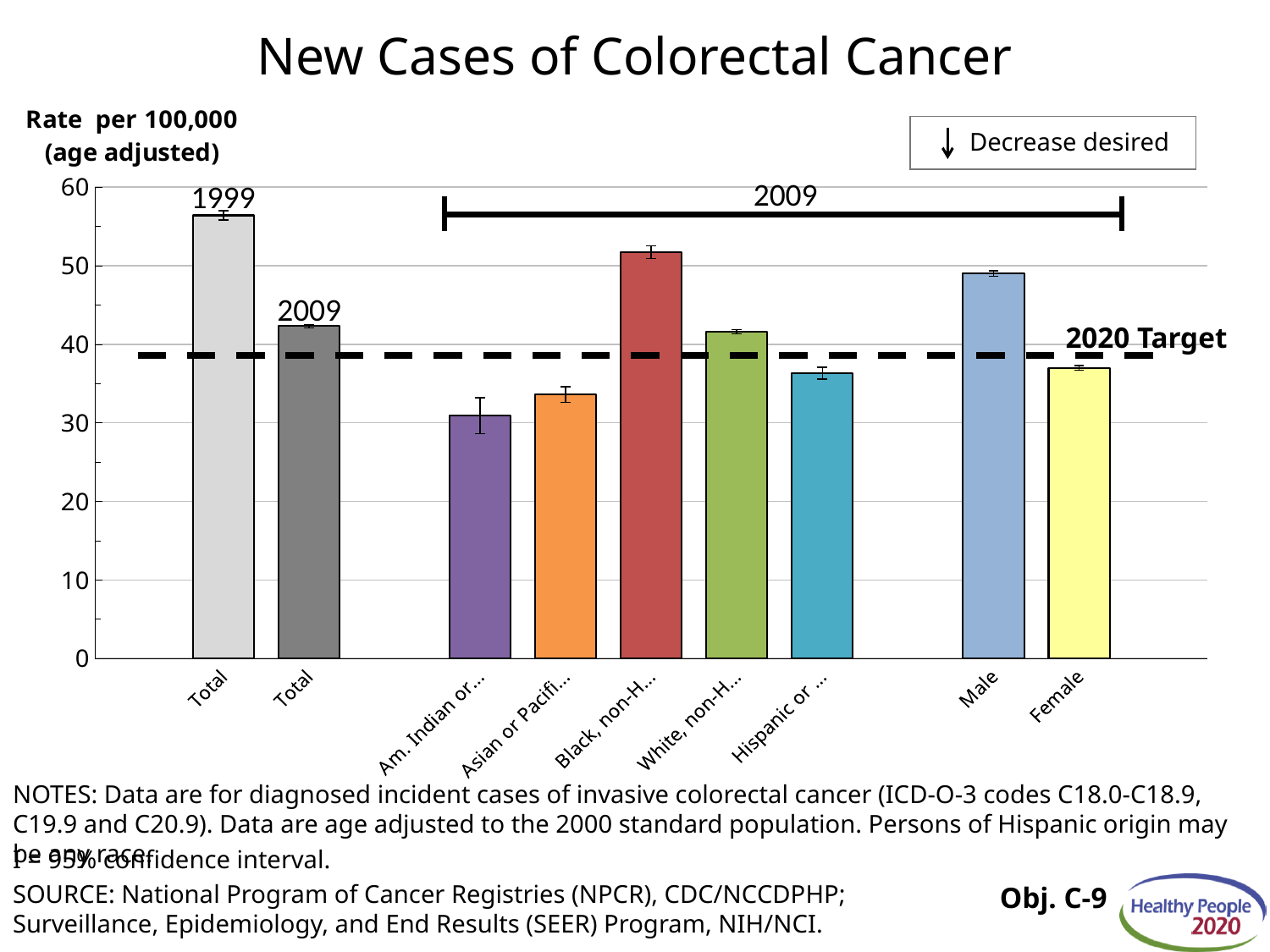
Which bar is the highest in the chart? Total (1999) Is the value for Total in 2009 greater or less than 40? greater Is the value for Total in 1999 greater or less than 50? greater How many bars are plotted in the chart? 9 What does the horizontal dashed line in the chart represent? 2020 Target Is the value for Male greater or less than 40? greater What kind of chart is shown on the slide? bar chart Which is larger, the value for Male or the value for Female? Male Which bar is the lowest in the chart? Am. Indian or... Did the Total rate rise or fall from 1999 to 2009? fall